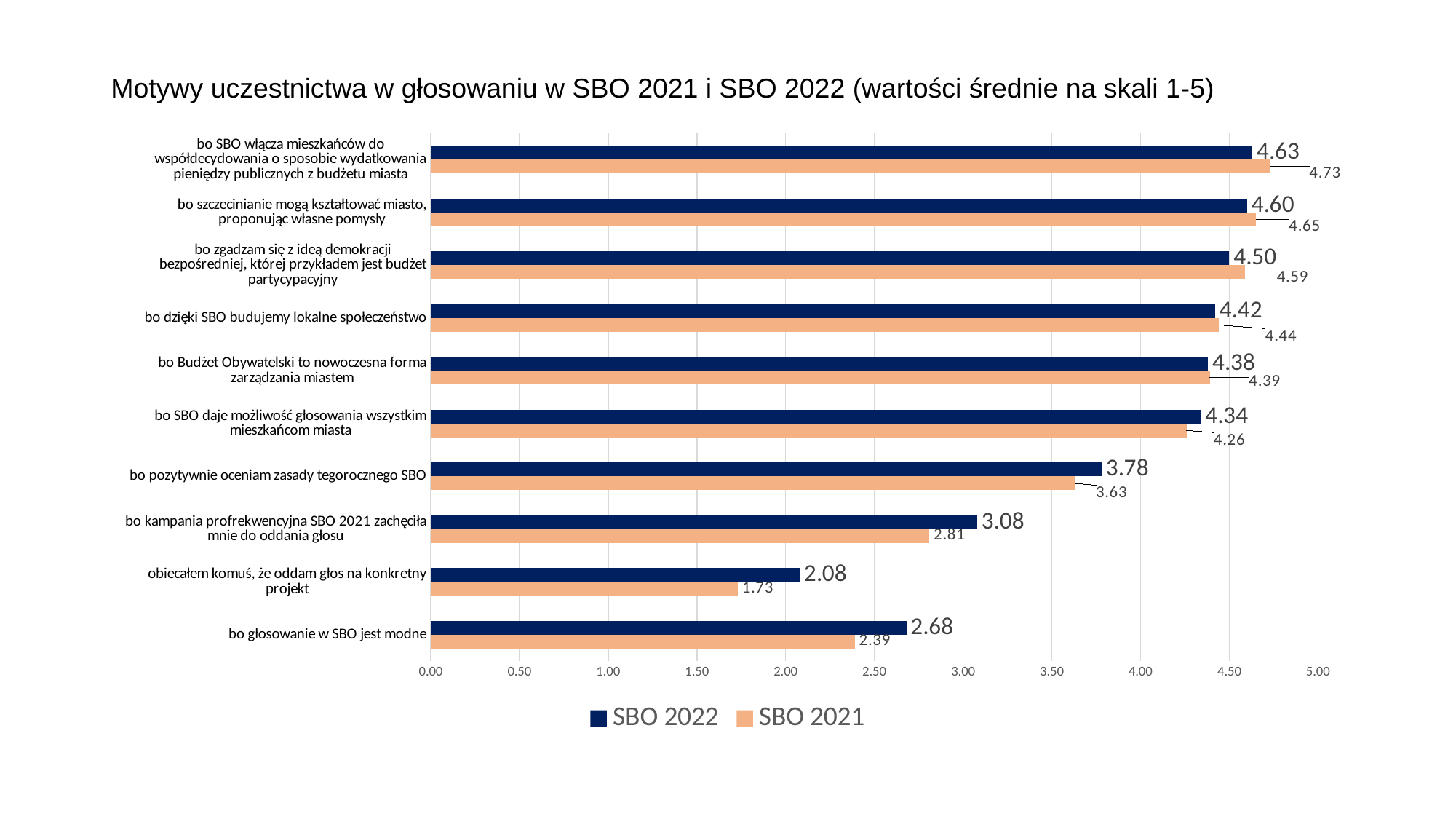
What is the SBO 2021 value for "obiecałem komuś, że oddam głos na konkretny projekt"? 1.73 Which category has the lowest SBO 2021 value? obiecałem komuś, że oddam głos na konkretny projekt How many categories are shown on the chart? 10 Which colour represents the SBO 2021 series? Orange What type of chart is shown on the slide? Bar chart Is the SBO 2022 value for "bo głosowanie w SBO jest modne" greater or less than 2.50? greater What is the difference between the SBO 2022 and SBO 2021 values for "bo kampania profrekwencyjna SBO 2021 zachęciła mnie do oddania głosu"? 0.27 How many series does the legend list? 2 For "bo SBO daje możliwość głosowania wszystkim mieszkańcom miasta", which series has the larger value, SBO 2022 or SBO 2021? SBO 2022 What is the SBO 2021 value for "bo głosowanie w SBO jest modne"? 2.39 Which category has the highest SBO 2022 value? bo SBO włącza mieszkańców do współdecydowania o sposobie wydatkowania pieniędzy publicznych z budżetu miasta What is the SBO 2022 value for "bo pozytywnie oceniam zasady tegorocznego SBO"? 3.78